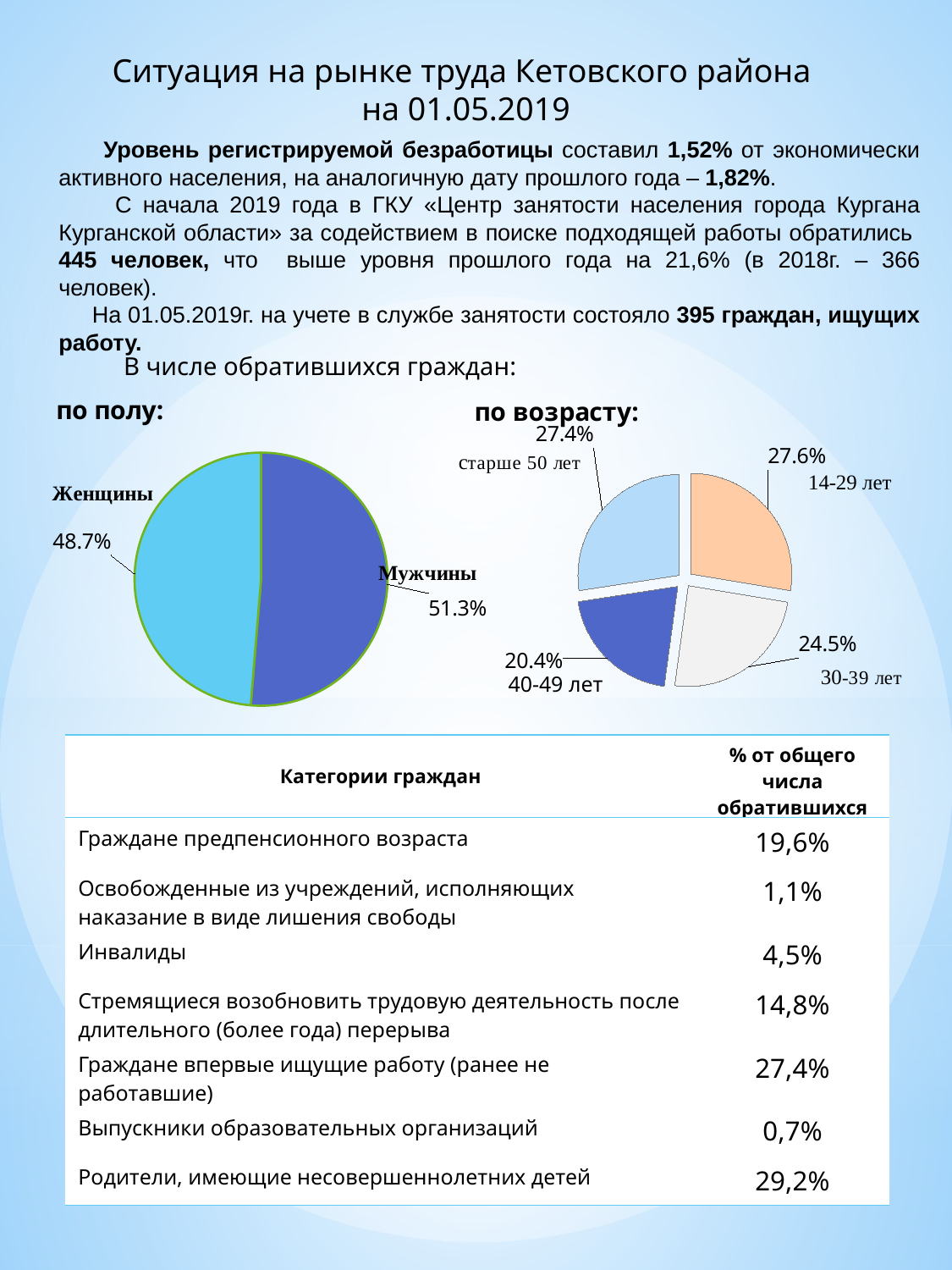
In the "по возрасту" chart, what share is labelled for 30-39 лет? 24.5% What kind of chart is the "по полу" chart? pie chart In the "по полу" chart, what is the difference between the Мужчины and Женщины shares? 2.6% In the "по полу" chart, what share is labelled for Женщины? 48.7% In the "по возрасту" chart, which slice is larger, 30-39 лет or 40-49 лет? 30-39 лет In the "по возрасту" chart, what share is labelled for старше 50 лет? 27.4% In the "по возрасту" chart, what share is labelled for 14-29 лет? 27.6% How many slices does the "по возрасту" pie chart have? 4 In the "по возрасту" chart, which age group has the smallest share? 40-49 лет In the "по возрасту" chart, what is the difference between the 30-39 лет and 40-49 лет shares? 4.1% In the "по полу" chart, which slice is larger, Мужчины or Женщины? Мужчины In the "по полу" chart, what share is labelled for Мужчины? 51.3%